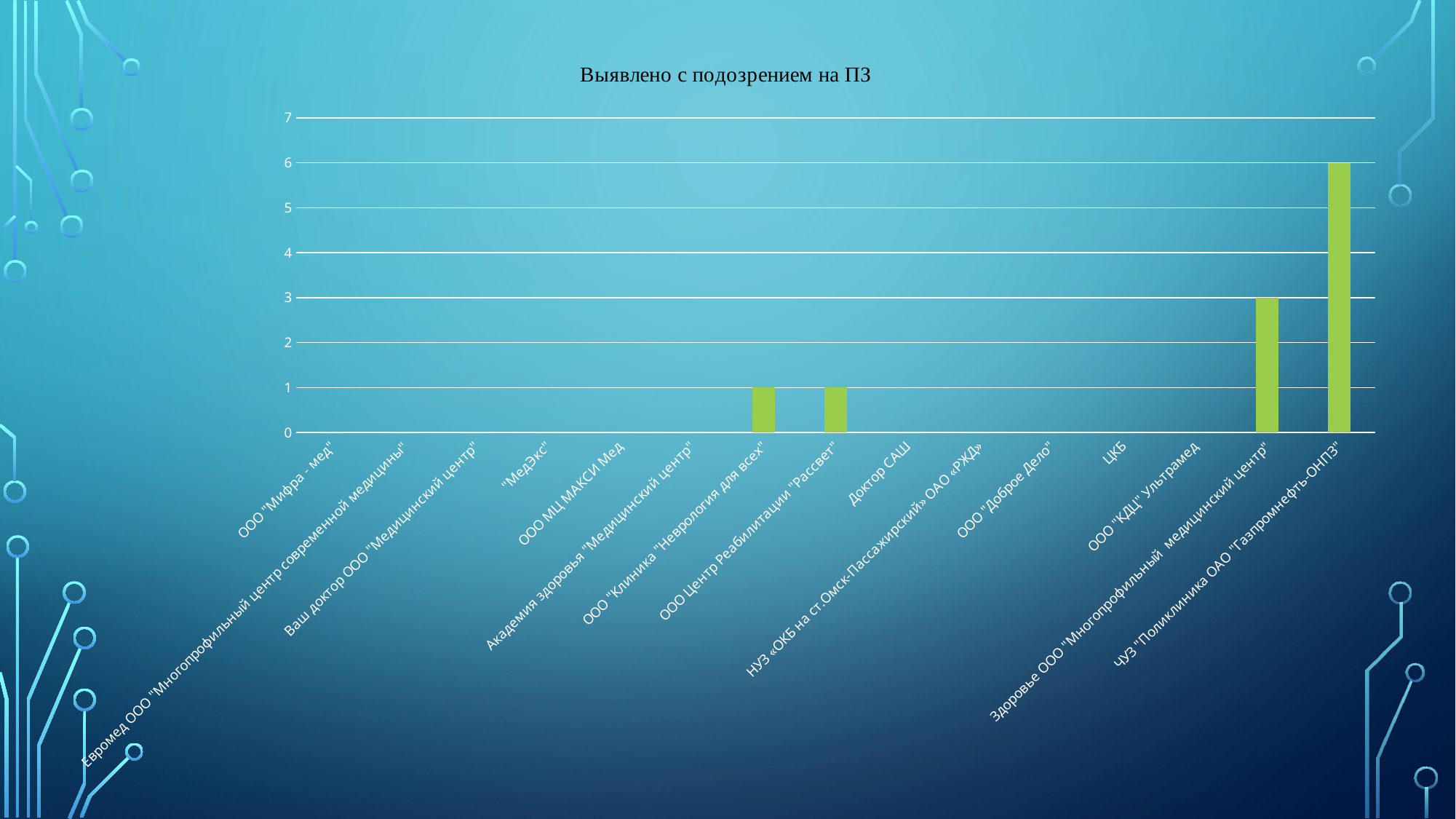
What is the value for ЧУЗ "Поликлиника ОАО "Газпромнефть-ОНПЗ"? 6 What is the value for ООО "Клиника "Неврология для всех"? 1 What is the value for Здоровье ООО "Многопрофильный медицинский центр"? 3 What is the value for ЦКБ? 0 Which category has the highest value? ЧУЗ "Поликлиника ОАО "Газпромнефть-ОНПЗ" What is the difference between the values for ЧУЗ "Поликлиника ОАО "Газпромнефть-ОНПЗ" and Здоровье ООО "Многопрофильный медицинский центр"? 3 How many categories are shown on the x axis? 15 What kind of chart is shown on the slide? bar chart What is the title of the chart? Выявлено с подозрением на ПЗ Which is larger, the value for Здоровье ООО "Многопрофильный медицинский центр" or the value for ООО Центр Реабилитации "Рассвет"? Здоровье ООО "Многопрофильный медицинский центр" What is the value for ООО Центр Реабилитации "Рассвет"? 1 Is the value for ЧУЗ "Поликлиника ОАО "Газпромнефть-ОНПЗ" greater or less than 4? greater